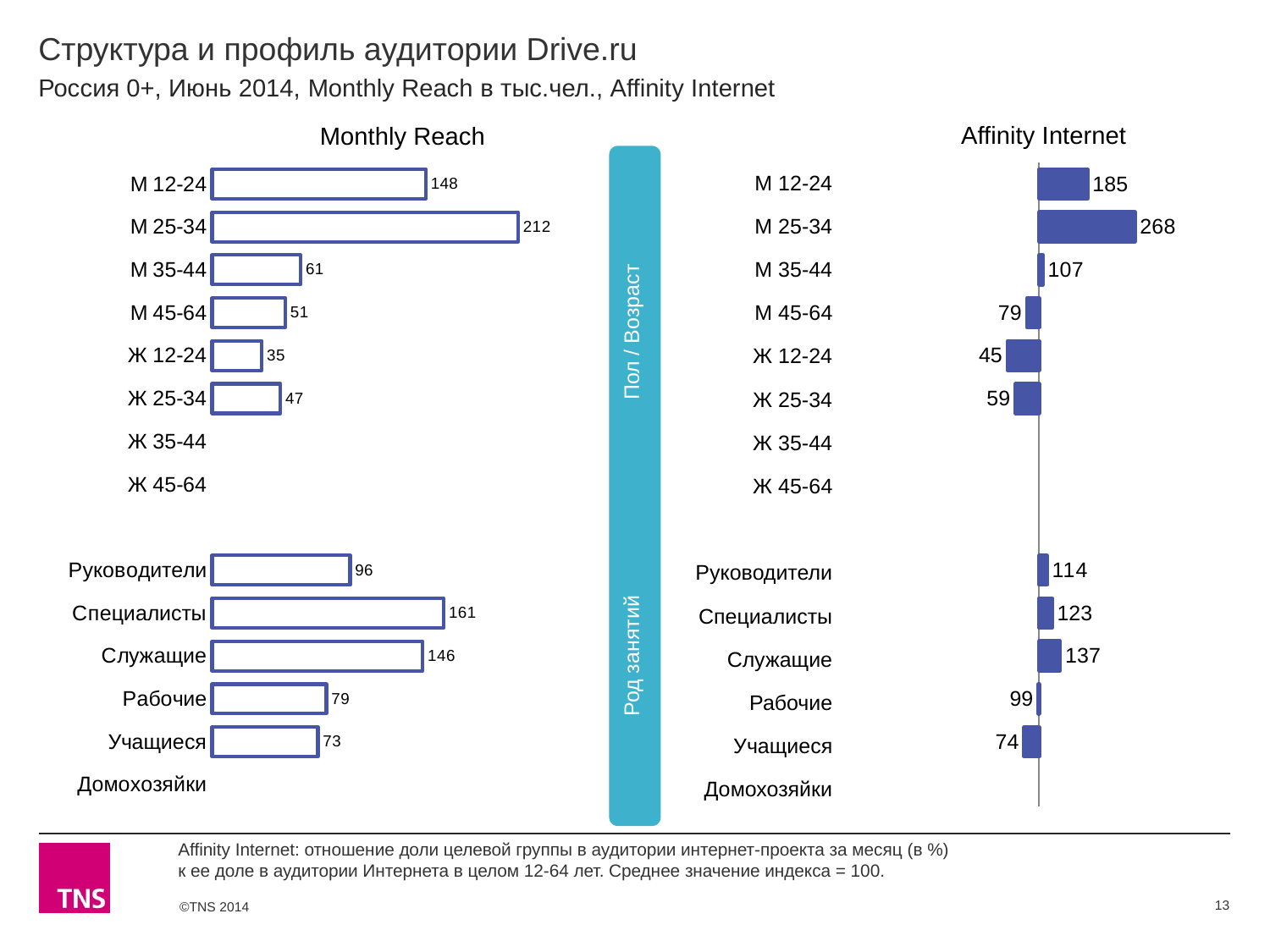
In the Affinity Internet chart, what is the value for Рабочие? 99 In the Affinity Internet chart, what is the value for Служащие? 137 What type of chart is the Monthly Reach chart? Bar chart In the Monthly Reach chart, what is the value for Специалисты? 161 In the Affinity Internet chart, what is the difference between М 25-34 and М 12-24? 83 In the Monthly Reach chart, which is larger, Рабочие or Учащиеся? Рабочие In the Affinity Internet chart, which occupation group has the lowest value? Учащиеся In the Monthly Reach chart, what is the difference between М 12-24 and М 35-44? 87 In the Affinity Internet chart, what is the value for Ж 12-24? 45 In the Affinity Internet chart, which is larger, Ж 25-34 or М 45-64? М 45-64 In the Monthly Reach chart, which gender/age group has the highest value? М 25-34 In the Monthly Reach chart, what is the value for М 25-34? 212